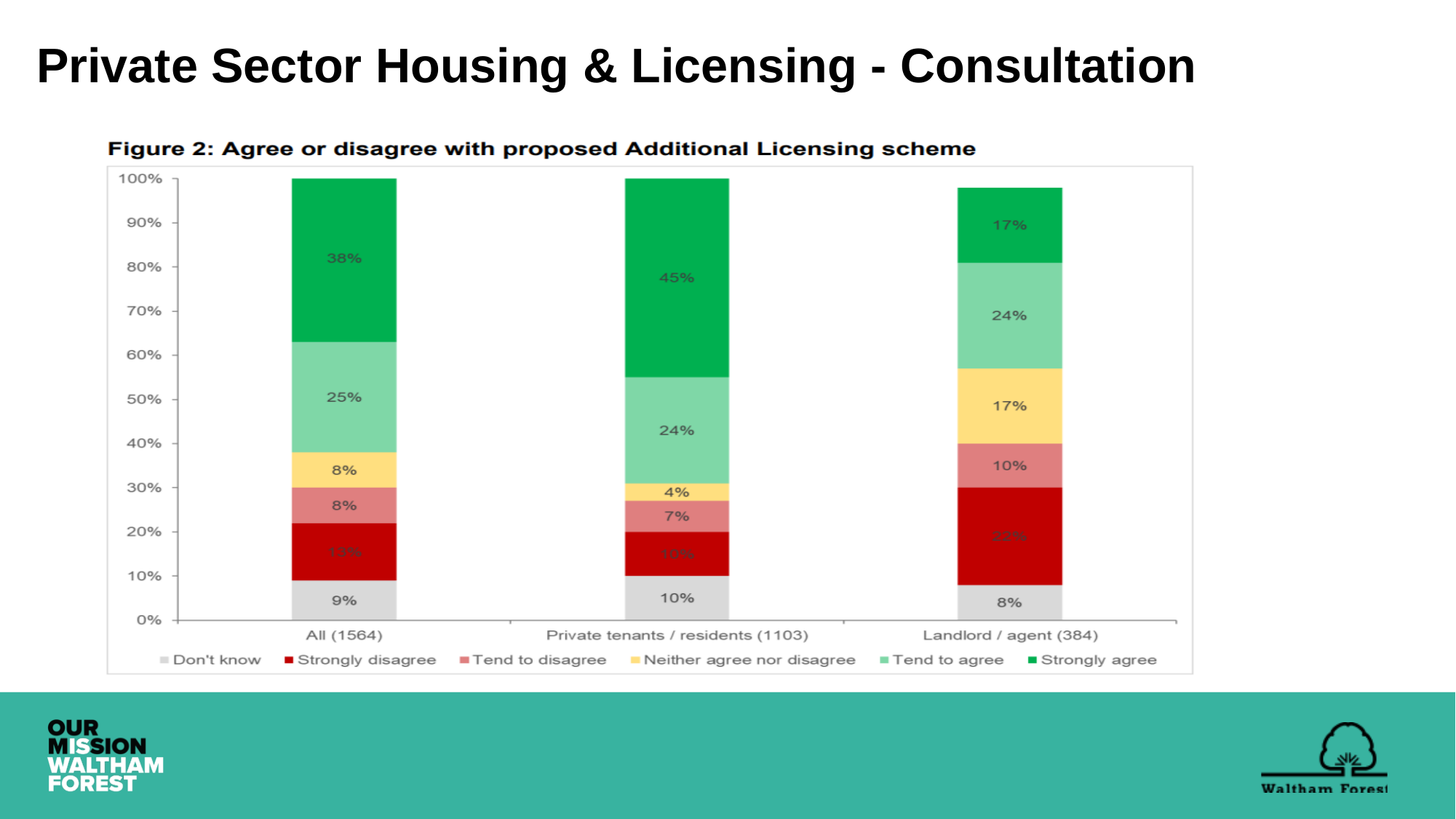
What is the 'Neither agree nor disagree' value for All (1564)? 8% What kind of chart is shown in Figure 2? Stacked bar chart Which respondent group has the lowest 'Don't know' percentage? Landlord / agent (384) What is the difference in 'Strongly agree' percentage between All (1564) and Landlord / agent (384)? 21 percentage points Which group has the larger 'Neither agree nor disagree' share: Private tenants / residents (1103) or Landlord / agent (384)? Landlord / agent (384) What is the 'Tend to disagree' value for Landlord / agent (384)? 10% What is the title of the chart on the slide? Figure 2: Agree or disagree with proposed Additional Licensing scheme How many series does the legend of Figure 2 list? 6 What percentage of Private tenants / residents (1103) strongly agree with the proposed Additional Licensing scheme? 45% How many respondent groups (categories) are shown on the x axis of Figure 2? 3 What is the 'Tend to agree' value for Landlord / agent (384)? 24% Which respondent group has the highest 'Strongly agree' percentage? Private tenants / residents (1103)